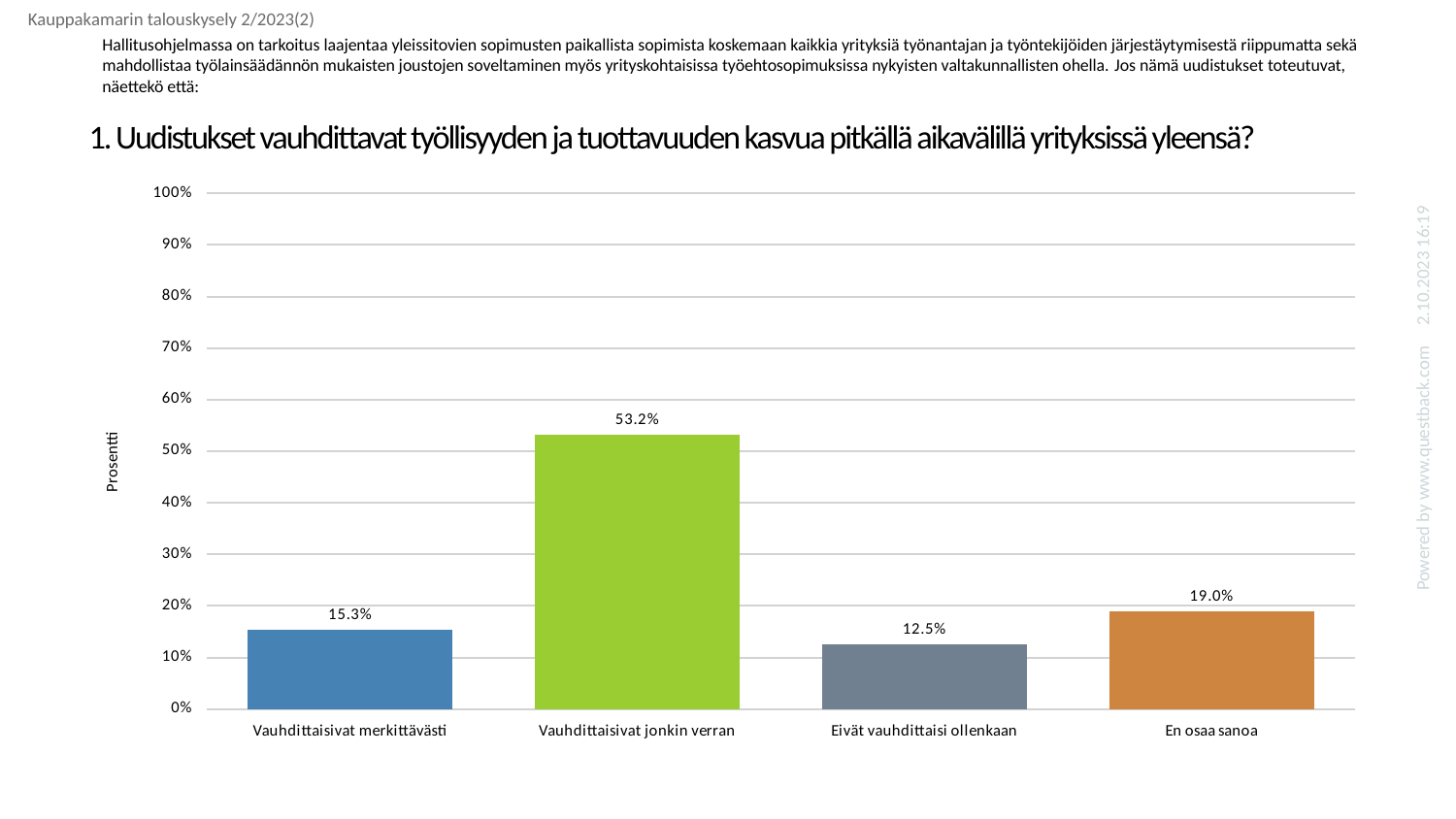
How many categories are shown on the x axis? 4 What is the value for "Eivät vauhdittaisi ollenkaan"? 12.5% Which category has the highest value? Vauhdittaisivat jonkin verran Which is larger, the value for "En osaa sanoa" or the value for "Vauhdittaisivat merkittävästi"? En osaa sanoa What is the difference between the values for "Vauhdittaisivat jonkin verran" and "Vauhdittaisivat merkittävästi"? 37.9% What is the value for "Vauhdittaisivat jonkin verran"? 53.2% Which category has the lowest value? Eivät vauhdittaisi ollenkaan What kind of chart is shown on the slide? bar chart Is the value for "Vauhdittaisivat jonkin verran" greater or less than 50%? greater What is the label of the y axis? Prosentti What is the value for "Vauhdittaisivat merkittävästi"? 15.3% What is the value for "En osaa sanoa"? 19.0%